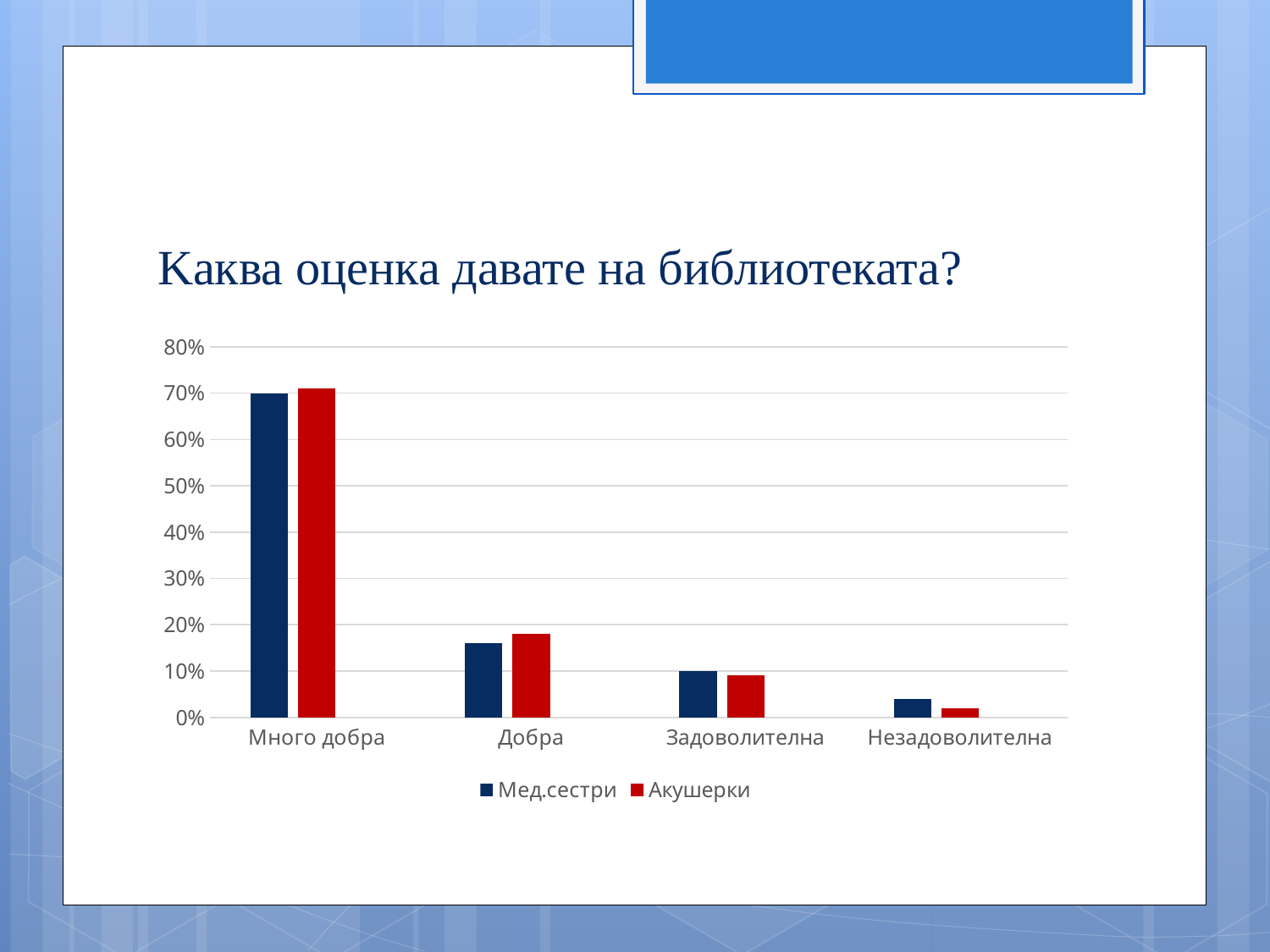
What is the title of the chart? Каква оценка давате на библиотеката? Is the value for Акушерки in Незадоволителна greater or less than 10%? less In the Добра category, which series has the larger value, Мед.сестри or Акушерки? Акушерки Which category has the highest value for Мед.сестри? Много добра Is the value for Мед.сестри in Добра greater or less than 20%? less Which colour represents the Акушерки series? red What kind of chart is shown on the slide? bar chart How many categories are shown on the x axis? 4 How many series does the legend list? 2 Which category has the lowest value for Акушерки? Незадоволителна Is the value for Акушерки in Много добра greater or less than 60%? greater Do the values for Мед.сестри rise or fall from left to right along the x axis? fall